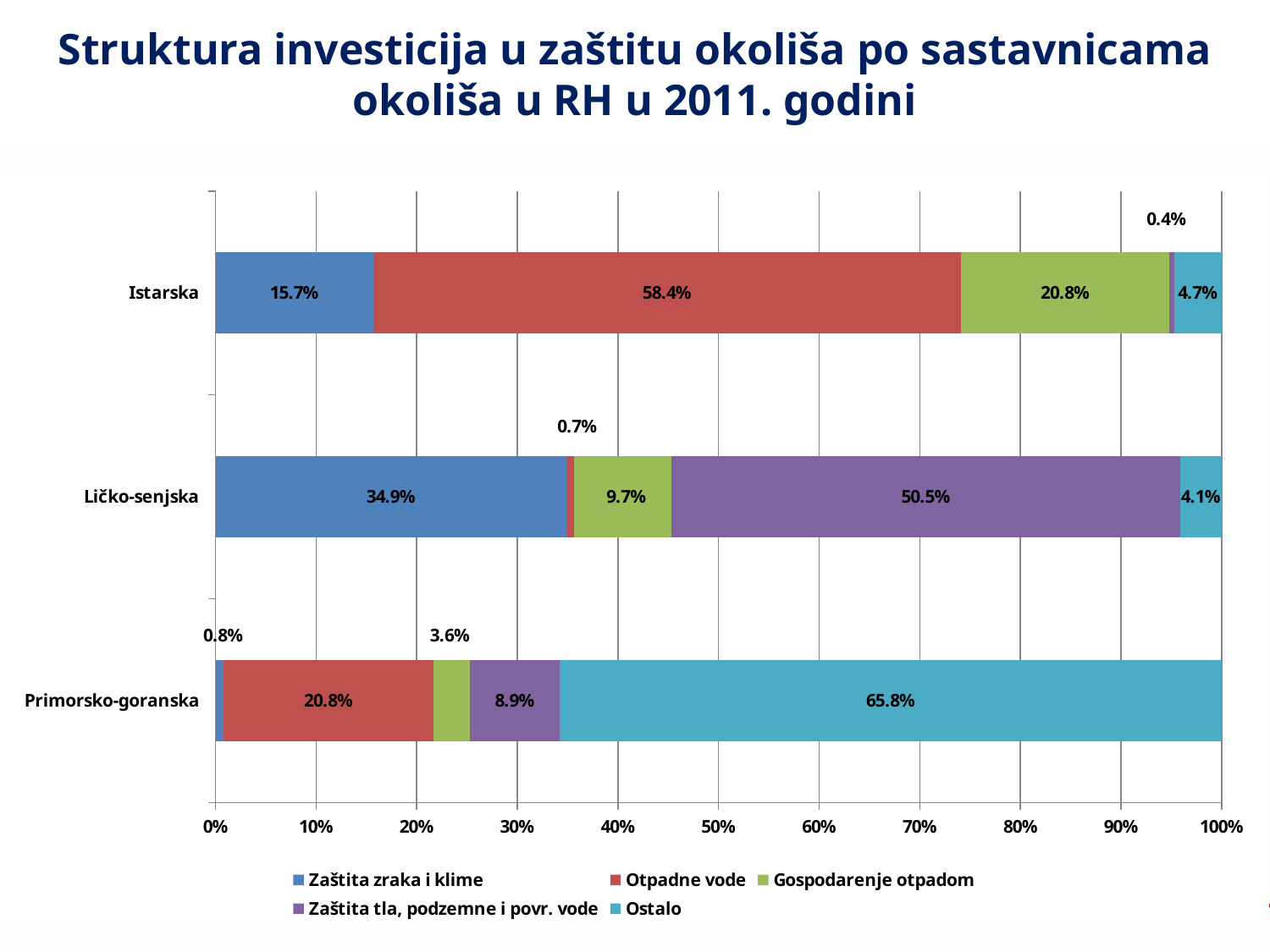
What is the value of Ostalo for Primorsko-goranska? 65.8% What kind of chart is shown on the slide? Stacked bar chart What is the value of Zaštita zraka i klime for Ličko-senjska? 34.9% What is the value of Otpadne vode for Istarska? 58.4% What is the value of Zaštita tla, podzemne i povr. vode for Ličko-senjska? 50.5% Which county has the lowest value for Zaštita zraka i klime? Primorsko-goranska Which colour represents Gospodarenje otpadom in the chart? Green Which county has the highest value for Ostalo? Primorsko-goranska How many counties are shown on the chart? 3 Which is larger: Otpadne vode for Istarska or Otpadne vode for Primorsko-goranska? Istarska What is the difference between the Gospodarenje otpadom values for Istarska and Ličko-senjska? 11.1% How many series does the legend list? 5